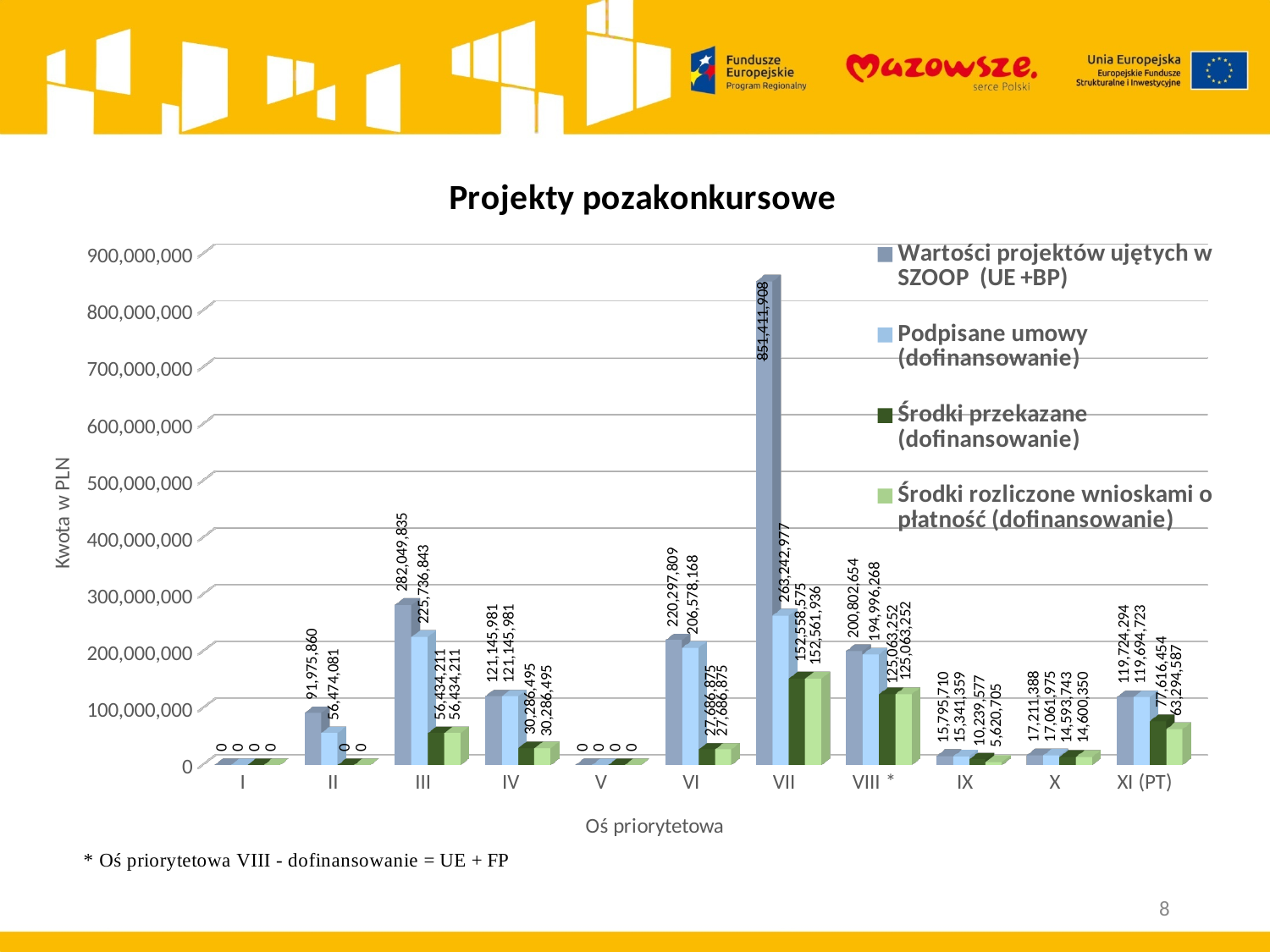
What type of chart is shown on the slide? Bar chart Which is larger: 'Podpisane umowy (dofinansowanie)' for oś priorytetowa VI or for oś priorytetowa VIII? VI What is the value of 'Wartości projektów ujętych w SZOOP (UE +BP)' for oś priorytetowa VII? 851,411,908 Which oś priorytetowa has the highest value of 'Wartości projektów ujętych w SZOOP (UE +BP)'? VII What is the value of 'Środki przekazane (dofinansowanie)' for oś priorytetowa IX? 10,239,577 What is the value of 'Środki rozliczone wnioskami o płatność (dofinansowanie)' for oś priorytetowa XI (PT)? 63,294,587 What is the value of 'Podpisane umowy (dofinansowanie)' for oś priorytetowa III? 225,736,843 What is the difference between 'Środki przekazane (dofinansowanie)' and 'Środki rozliczone wnioskami o płatność (dofinansowanie)' for oś priorytetowa XI (PT)? 14,321,867 How many osie priorytetowe (categories) are shown on the x axis? 11 What is the difference between 'Wartości projektów ujętych w SZOOP (UE +BP)' and 'Podpisane umowy (dofinansowanie)' for oś priorytetowa III? 56,312,992 How many series does the legend list? 4 Is the value of 'Podpisane umowy (dofinansowanie)' for oś priorytetowa VII greater or less than 200,000,000? greater